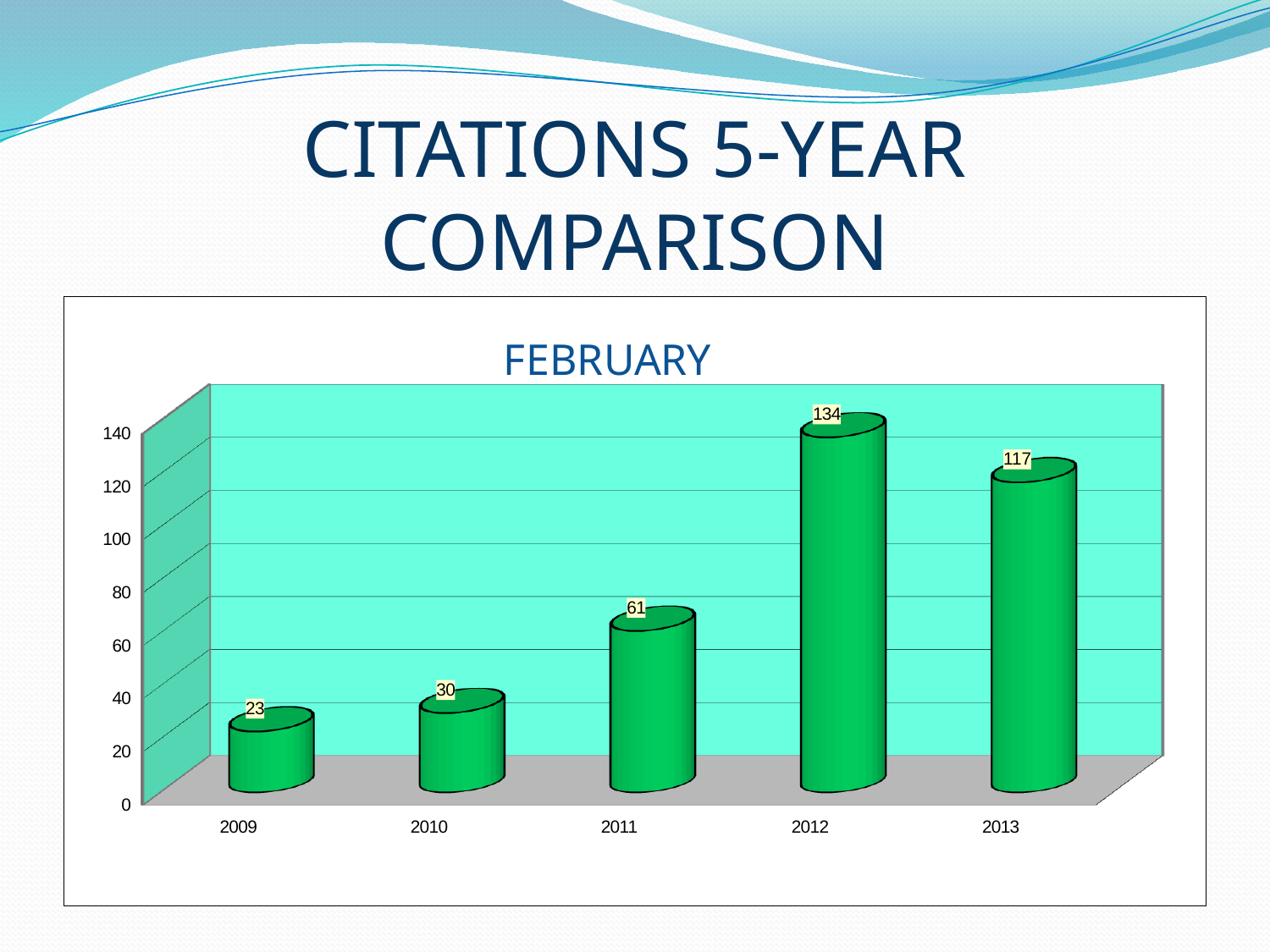
Which year has the highest value? 2012 What is the value for 2011? 61 What is the difference between the values for 2012 and 2013? 17 What is the value for 2012? 134 What is the difference between the values for 2011 and 2010? 31 What is the value for 2009? 23 What is the title of the chart? FEBRUARY Which year has the lowest value? 2009 Which is larger, the value for 2010 or the value for 2011? 2011 What kind of chart is shown on the slide? bar chart How many years are shown on the chart? 5 Is the value for 2013 greater or less than 100? greater